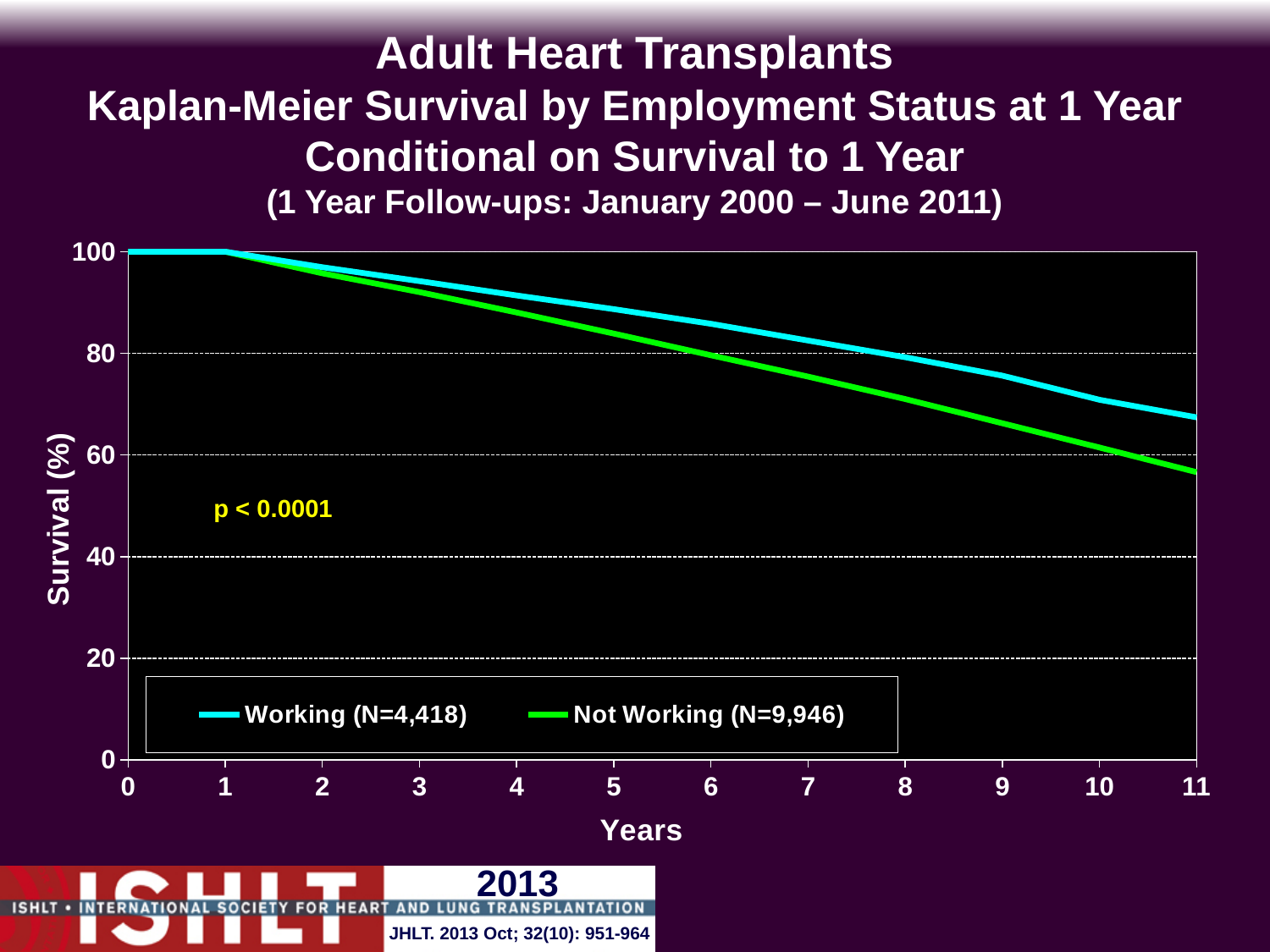
Is the survival value for the Working group at year 10 greater or less than 60? greater How many series does the legend list? 2 Is the survival value for the Not Working group at year 11 greater or less than 60? less What p-value is printed on the chart? p < 0.0001 What kind of chart is shown on the slide? line chart At year 11, which group has the higher survival, Working or Not Working? Working What is the N for the Not Working group shown in the legend? 9,946 Do the survival curves rise or fall as years increase? fall What is the survival value for the Working group at year 0? 100 Is the survival value for the Working group at year 5 greater or less than 80? greater